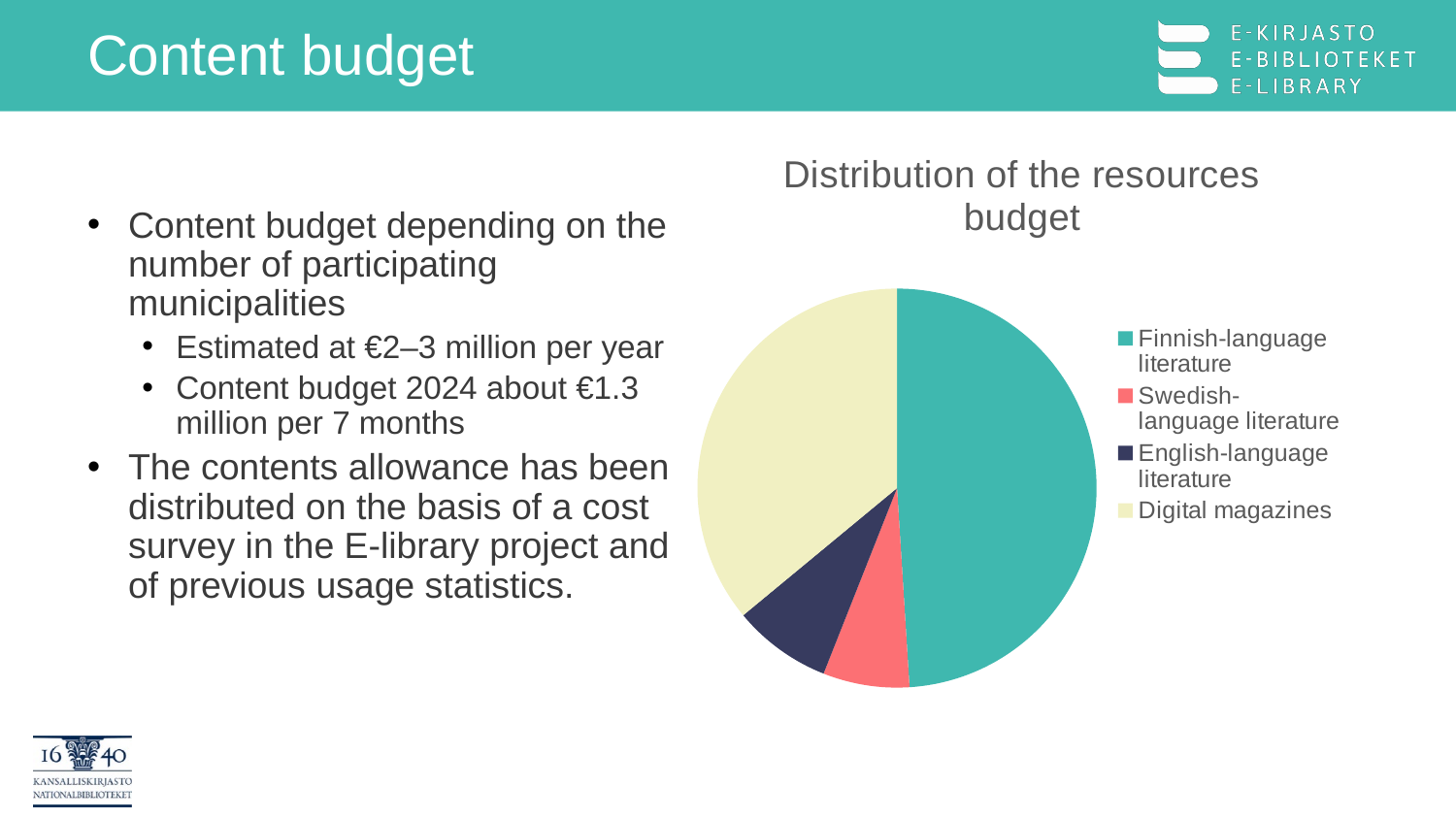
Which is larger: the share for Digital magazines or the share for English-language literature? Digital magazines What kind of chart is shown on the slide? Pie chart Which category is shown in the pale yellow colour in the pie chart? Digital magazines How many slices does the pie chart have? 4 What is the title of the chart? Distribution of the resources budget How many entries does the chart legend list? 4 Which category has the smallest share of the resources budget? Swedish-language literature Which is larger: the share for Finnish-language literature or the share for Digital magazines? Finnish-language literature Which category has the largest share of the resources budget? Finnish-language literature Which is larger: the share for English-language literature or the share for Swedish-language literature? English-language literature